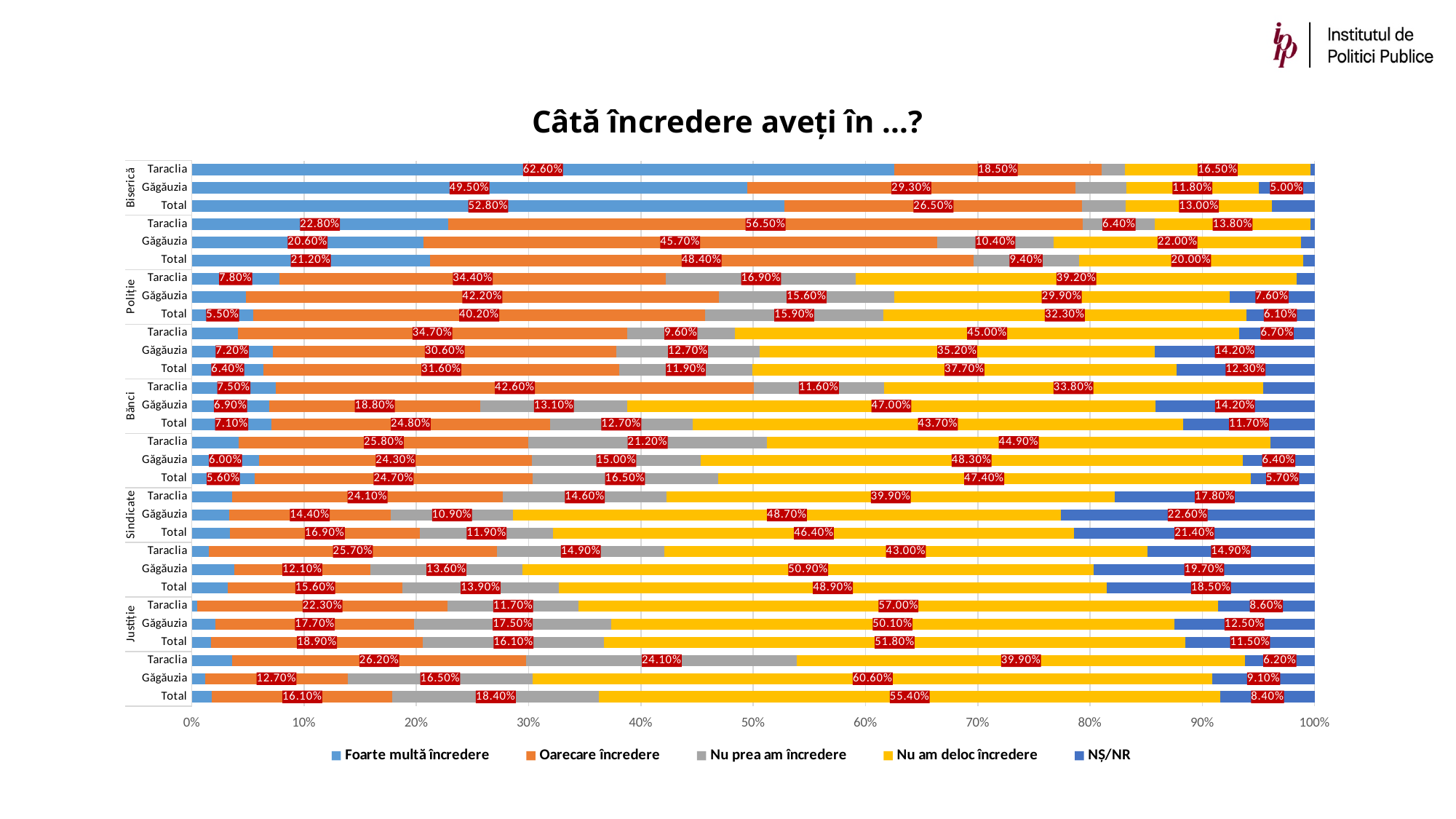
In the Sindicate group, which has the larger "Nu am deloc încredere" value: Găgăuzia or Taraclia? Găgăuzia In the Justiție group, what is the difference between the "Nu am deloc încredere" values for Taraclia and Găgăuzia? 6.90 percentage points In the Biserică group, what is the difference between the "Foarte multă încredere" values for Total and Găgăuzia? 3.30 percentage points In the Biserică group, which row has the highest "Foarte multă încredere" value? Taraclia What is the value of "Oarecare încredere" for Găgăuzia in the Poliție group? 42.20% What is the NȘ/NR value for Găgăuzia in the Bănci group? 14.20% What kind of chart is shown on the slide? Stacked bar chart How many series does the legend list? 5 What is the title of the chart? Câtă încredere aveți în ...? What is the value of "Nu am deloc încredere" for Total in the Justiție group? 51.80% What colour represents "Nu am deloc încredere" in the legend? Yellow What is the value of "Foarte multă încredere" for Taraclia in the Biserică group? 62.60%